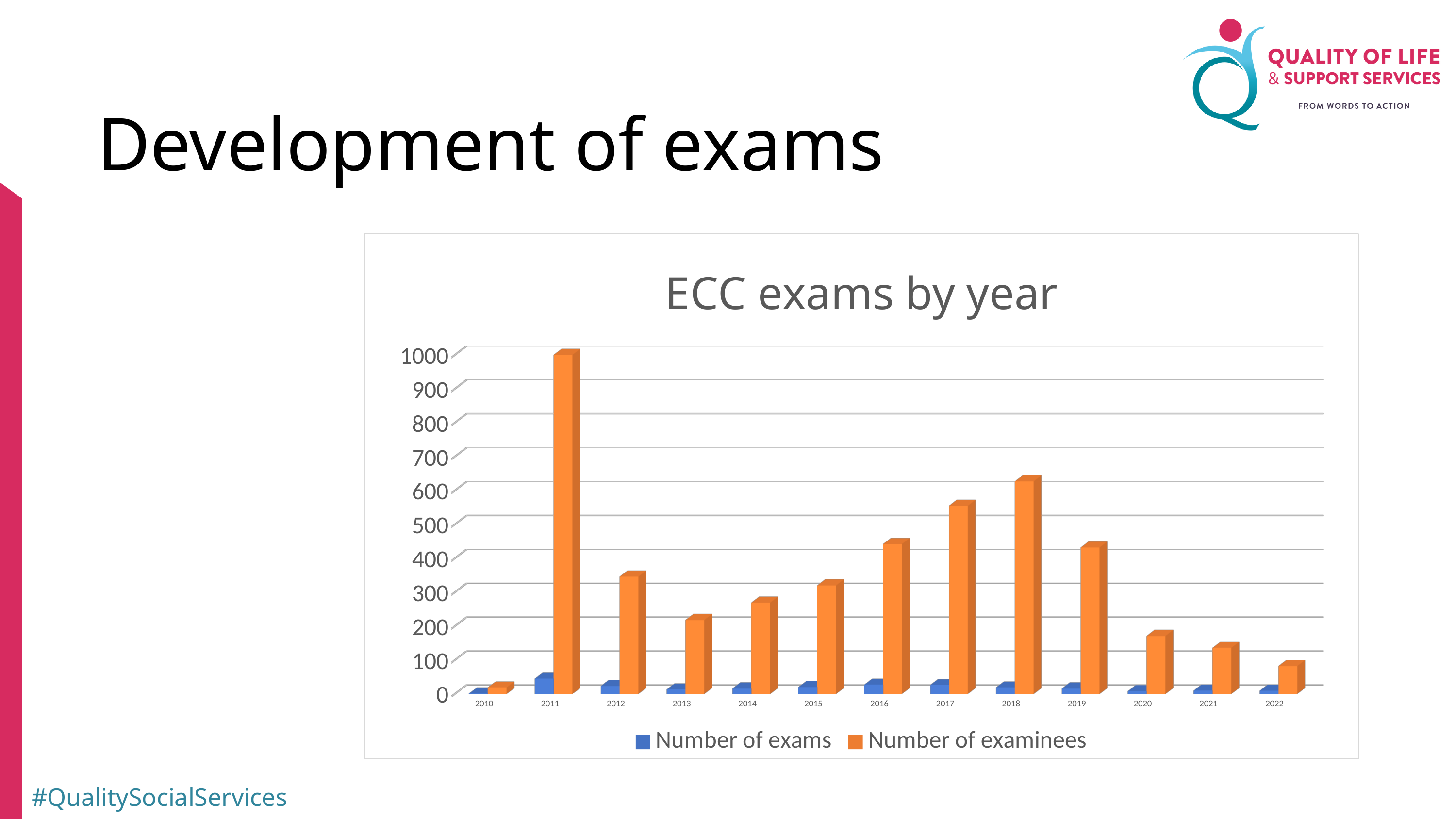
How many years are shown on the x axis of the chart? 13 How many series does the legend list? 2 Is the Number of examinees for 2011 greater or less than 900? greater Which year has the highest Number of examinees? 2011 Is the Number of examinees for 2017 greater or less than 400? greater Which year has the lowest Number of examinees? 2010 Is the Number of examinees for 2013 greater or less than 300? less Which year has the larger Number of examinees, 2018 or 2019? 2018 What is the title of the chart? ECC exams by year Does the Number of examinees rise or fall from 2018 to 2022? fall What kind of chart is shown on the slide? bar chart